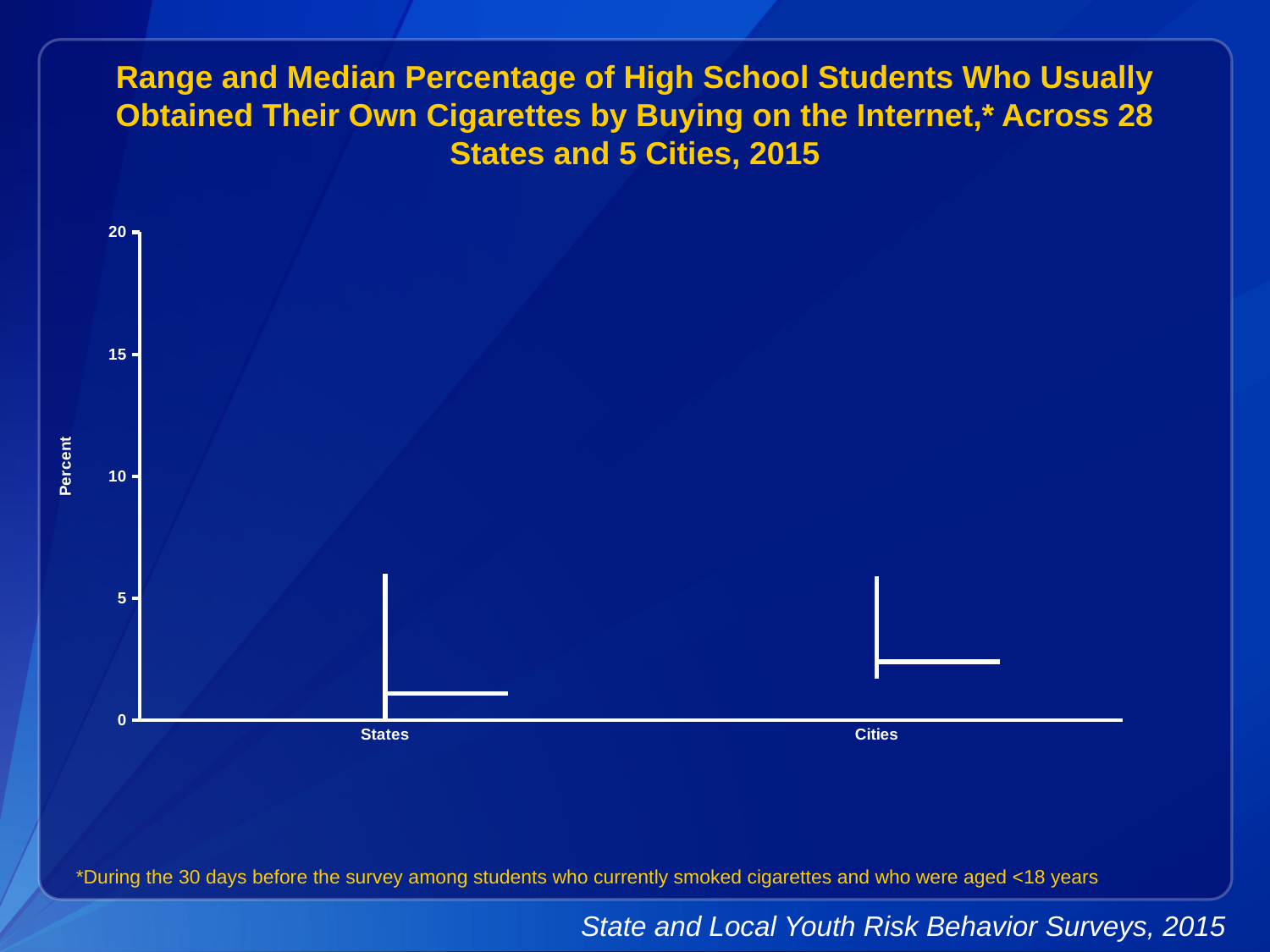
What is the highest value shown on the y axis? 20 Is the median value for States greater or less than 5? less Is the top of the range for States greater or less than 5? greater Is the median value for Cities greater or less than 5? less What are the two categories shown on the x axis? States and Cities Which category has the lower median value? States How many categories are shown on the x axis of the chart? 2 Which category has the higher median value, States or Cities? Cities What is the label of the y axis? Percent